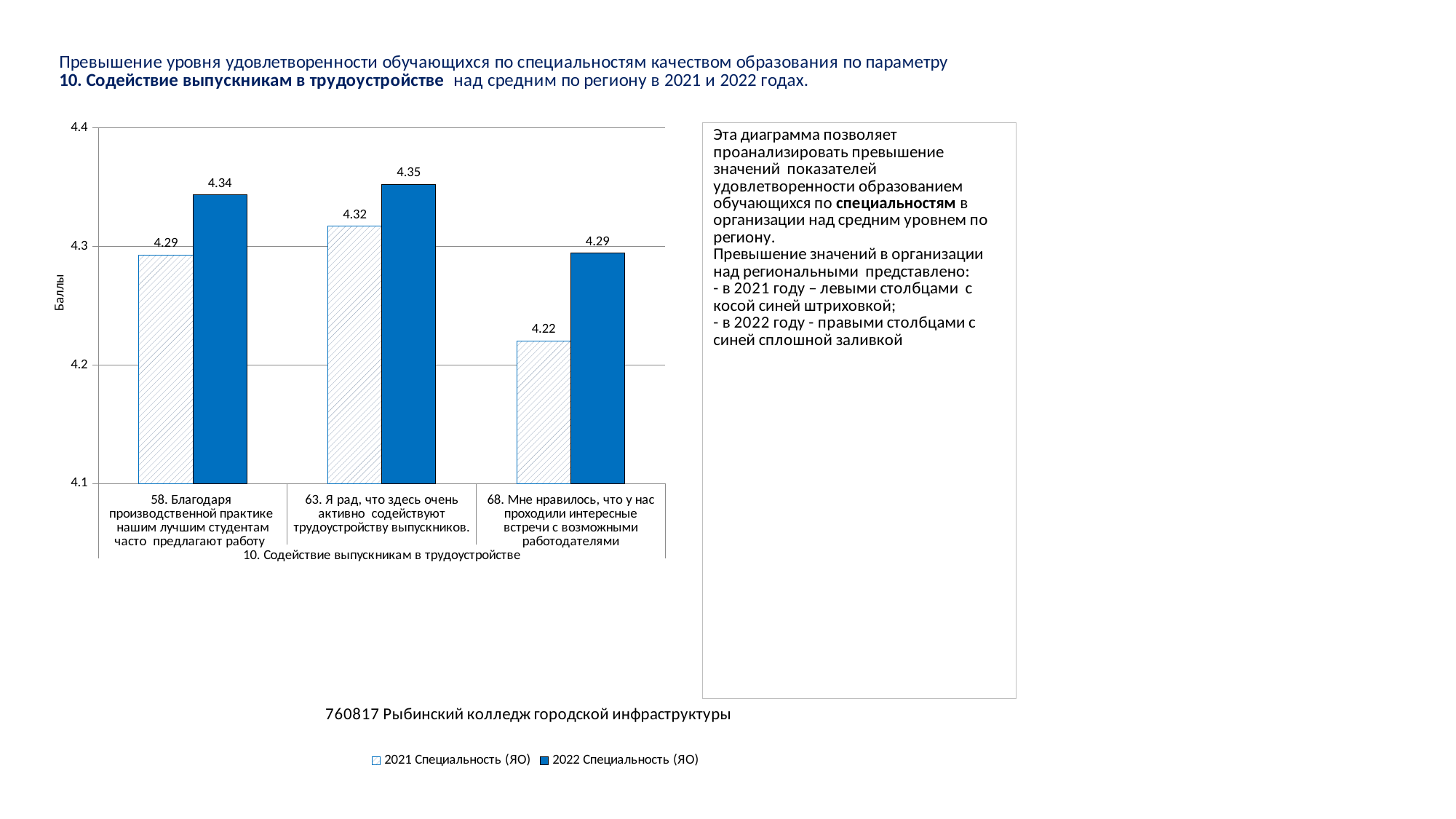
What is the value for the 2022 Специальность (ЯО) series for category 63 (Я рад, что здесь очень активно содействуют трудоустройству выпускников)? 4.35 What type of chart is shown on the slide? Bar chart Which category has the highest value in the 2022 Специальность (ЯО) series? 63. Я рад, что здесь очень активно содействуют трудоустройству выпускников. What is the value for the 2021 Специальность (ЯО) series for category 68 (Мне нравилось, что у нас проходили интересные встречи с возможными работодателями)? 4.22 What is the label of the vertical axis of the chart? Баллы What is the difference between the 2022 and 2021 values for category 68 (Мне нравилось, что у нас проходили интересные встречи с возможными работодателями)? 0.07 What is the value for the 2021 Специальность (ЯО) series for category 58 (Благодаря производственной практике нашим лучшим студентам часто предлагают работу)? 4.29 How many series does the chart legend list? 2 How many categories are shown on the x axis of the chart? 3 For category 58 (Благодаря производственной практике нашим лучшим студентам часто предлагают работу), which series has the larger value, 2021 or 2022? 2022 Специальность (ЯО) Is the 2021 value for category 68 (Мне нравилось, что у нас проходили интересные встречи с возможными работодателями) greater or less than 4.3? less Which category has the lowest value in the 2021 Специальность (ЯО) series? 68. Мне нравилось, что у нас проходили интересные встречи с возможными работодателями